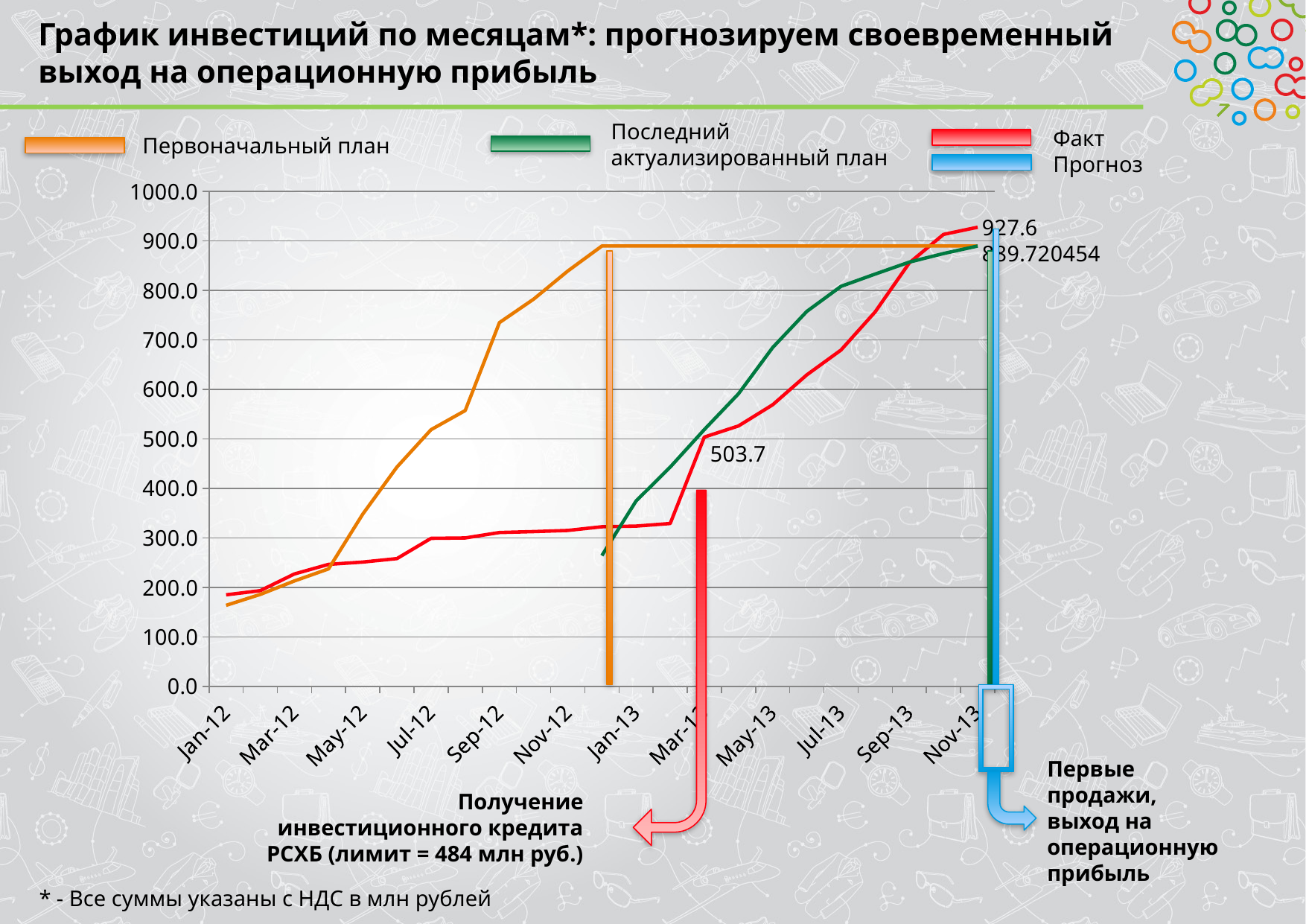
How many series does the legend list? 4 At Nov-13, which is higher: the Факт line or the Последний актуализированный план line? Факт How many month labels are shown on the x axis? 12 Is the value of Первоначальный план at Jan-13 greater or less than 800? greater What type of chart is shown on the slide? line chart What is the maximum value shown on the y axis? 1000.0 What value is labelled at the end of the Последний актуализированный план line at Nov-13? 889.720454 Is the value of Факт at May-13 greater or less than 500? greater At Jan-13, which is higher: the Первоначальный план line or the Факт line? Первоначальный план What value is labelled at the end of the Факт line at Nov-13? 927.6 Does the Факт line rise or fall from Jan-12 to Nov-13? rises Is the value of Первоначальный план at Jan-12 greater or less than 200? less